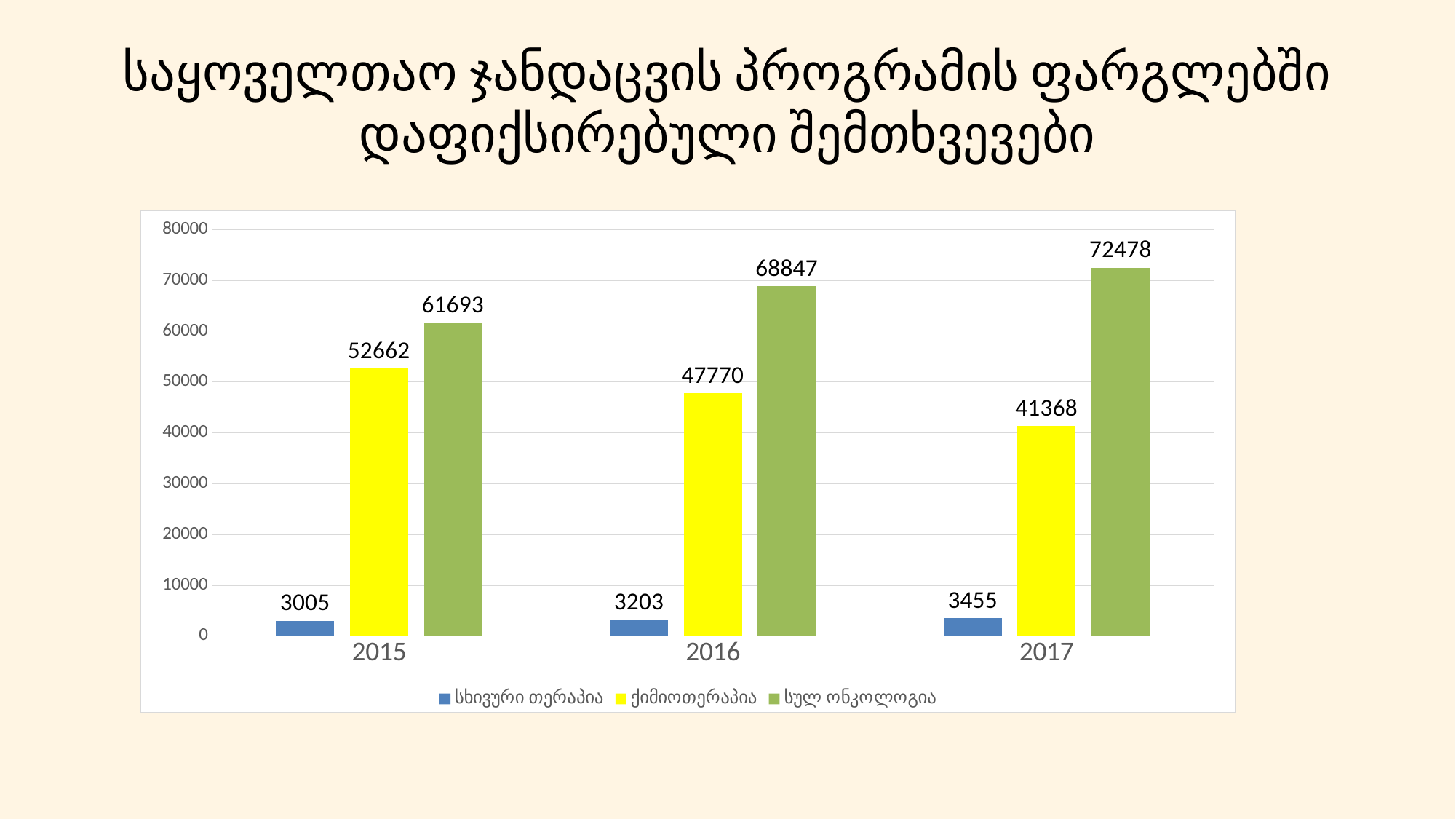
Is the value for სულ ონკოლოგია in 2016 greater or less than 60000? greater What is the difference between the სულ ონკოლოგია values for 2017 and 2015? 10785 In which year is the value for სულ ონკოლოგია highest? 2017 What is the value for სულ ონკოლოგია in 2017? 72478 Do the values for ქიმიოთერაპია rise or fall from 2015 to 2017? fall What kind of chart is shown on the slide? bar chart In which year is the value for ქიმიოთერაპია lowest? 2017 Which is larger: ქიმიოთერაპია in 2016 or ქიმიოთერაპია in 2017? ქიმიოთერაპია in 2016 What is the value for ქიმიოთერაპია in 2015? 52662 How many years are shown on the x axis? 3 What is the value for სხივური თერაპია in 2016? 3203 How many series does the legend list? 3